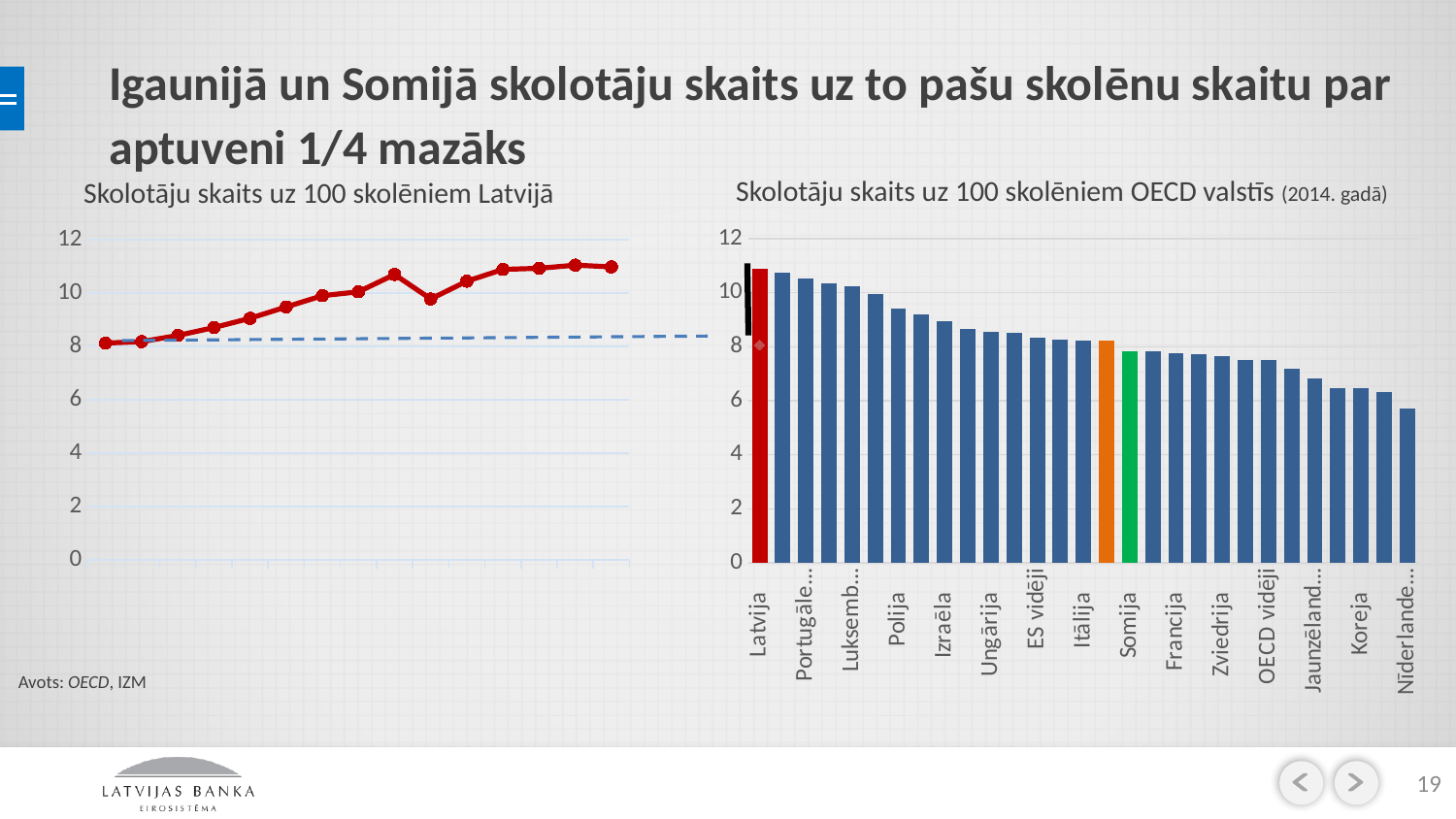
In the right chart 'Skolotāju skaits uz 100 skolēniem OECD valstīs', is the value for Latvija greater or less than 10? greater What kind of chart is the chart on the left, 'Skolotāju skaits uz 100 skolēniem Latvijā'? line chart What kind of chart is the chart on the right, 'Skolotāju skaits uz 100 skolēniem OECD valstīs'? bar chart In the right chart 'Skolotāju skaits uz 100 skolēniem OECD valstīs', which country has the highest value? Latvija In the right chart 'Skolotāju skaits uz 100 skolēniem OECD valstīs', which is larger, the value for Polija or the value for Koreja? Polija In the right chart 'Skolotāju skaits uz 100 skolēniem OECD valstīs', what colour is the bar for Somija? green In the right chart 'Skolotāju skaits uz 100 skolēniem OECD valstīs', which labelled country has the lowest value? Nīderlande In the right chart 'Skolotāju skaits uz 100 skolēniem OECD valstīs', is the value for Polija greater or less than 8? greater In the left chart 'Skolotāju skaits uz 100 skolēniem Latvijā', do the values generally rise or fall along the x axis? rise In the right chart 'Skolotāju skaits uz 100 skolēniem OECD valstīs', which is larger, the value for Latvija or the value for Somija? Latvija In the right chart 'Skolotāju skaits uz 100 skolēniem OECD valstīs', is the value for Koreja greater or less than 8? less